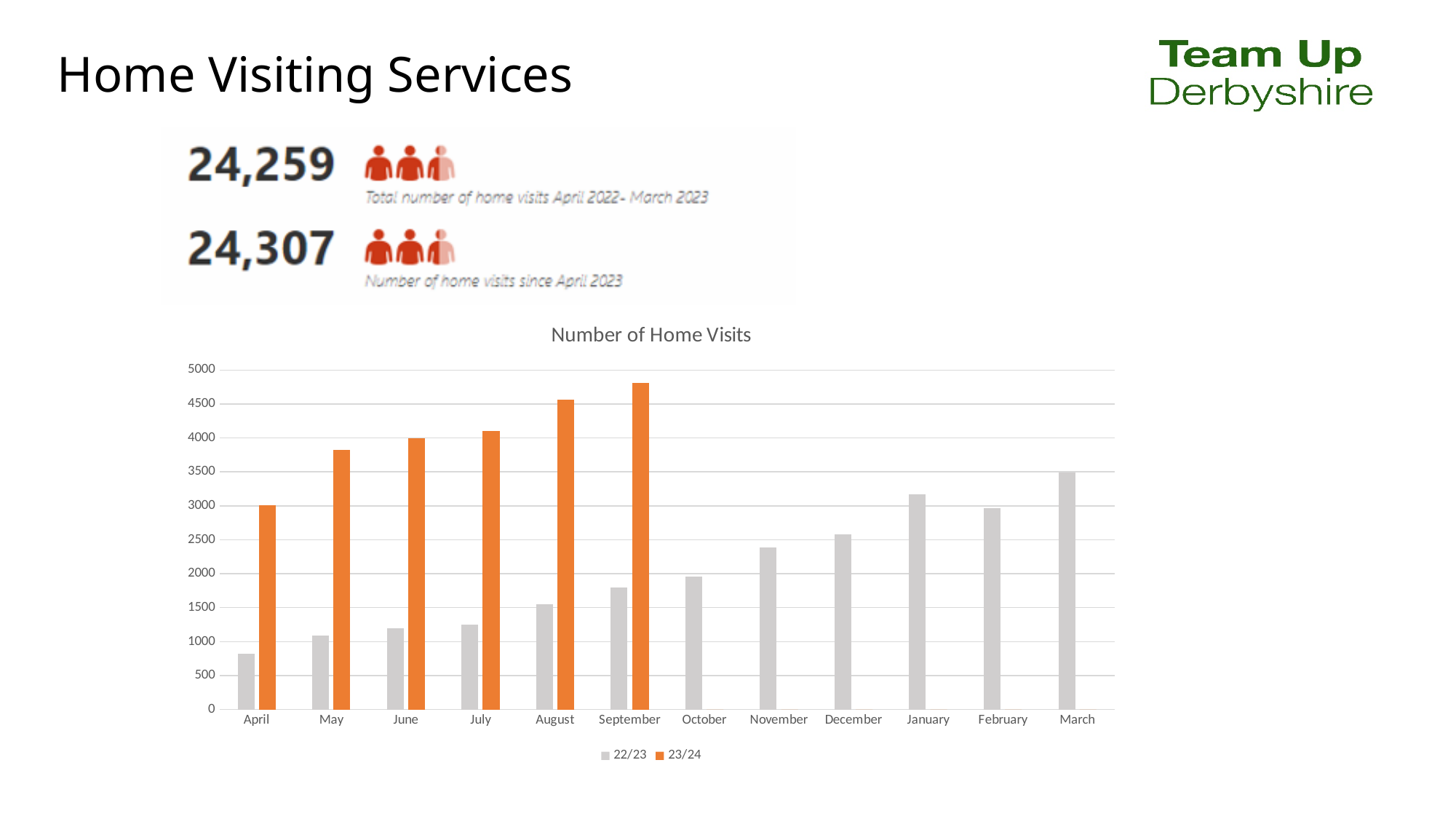
What type of chart is shown on the slide? bar chart How many series does the chart legend list? 2 Which month has the highest value for the 23/24 series? September How many months are shown on the x axis of the chart? 12 What is the title of the chart? Number of Home Visits Is the value for November in the 22/23 series greater or less than 2500? less Which month has the lowest value for the 22/23 series? April Is the value for September in the 23/24 series greater or less than 4500? greater Is the value for April in the 22/23 series greater or less than 1000? less In April, which series has the larger value, 22/23 or 23/24? 23/24 Do the values for the 23/24 series rise or fall from April to September? rise Which month has the highest value for the 22/23 series? March